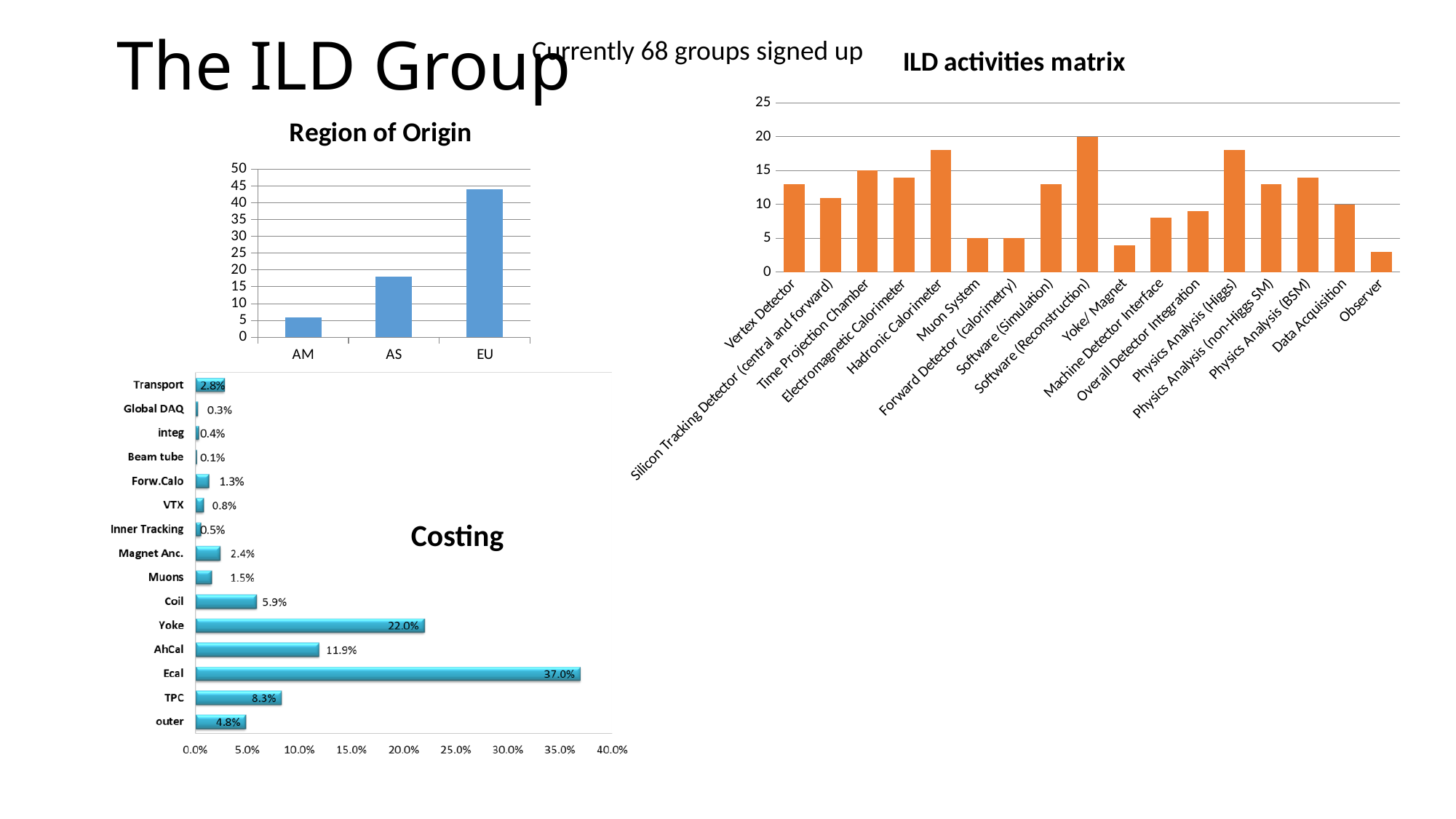
What kind of chart is the ILD activities matrix? Bar chart In the Costing chart, what is the value for Yoke? 22.0% In the ILD activities matrix chart, which activity has the highest value? Software (Reconstruction) In the Costing chart, which is larger, the value for TPC or the value for Coil? TPC In the Costing chart, what is the difference between the values for Ecal and AhCal? 25.1% In the Region of Origin chart, is the value for AS greater or less than 15? greater In the ILD activities matrix chart, is the value for Observer greater or less than 5? less In the Region of Origin chart, which region has the highest value? EU How many categories does the Costing chart show? 15 In the Costing chart, which category has the highest value? Ecal In the Costing chart, which category has the lowest value? Beam tube In the Costing chart, what is the value for Ecal? 37.0%